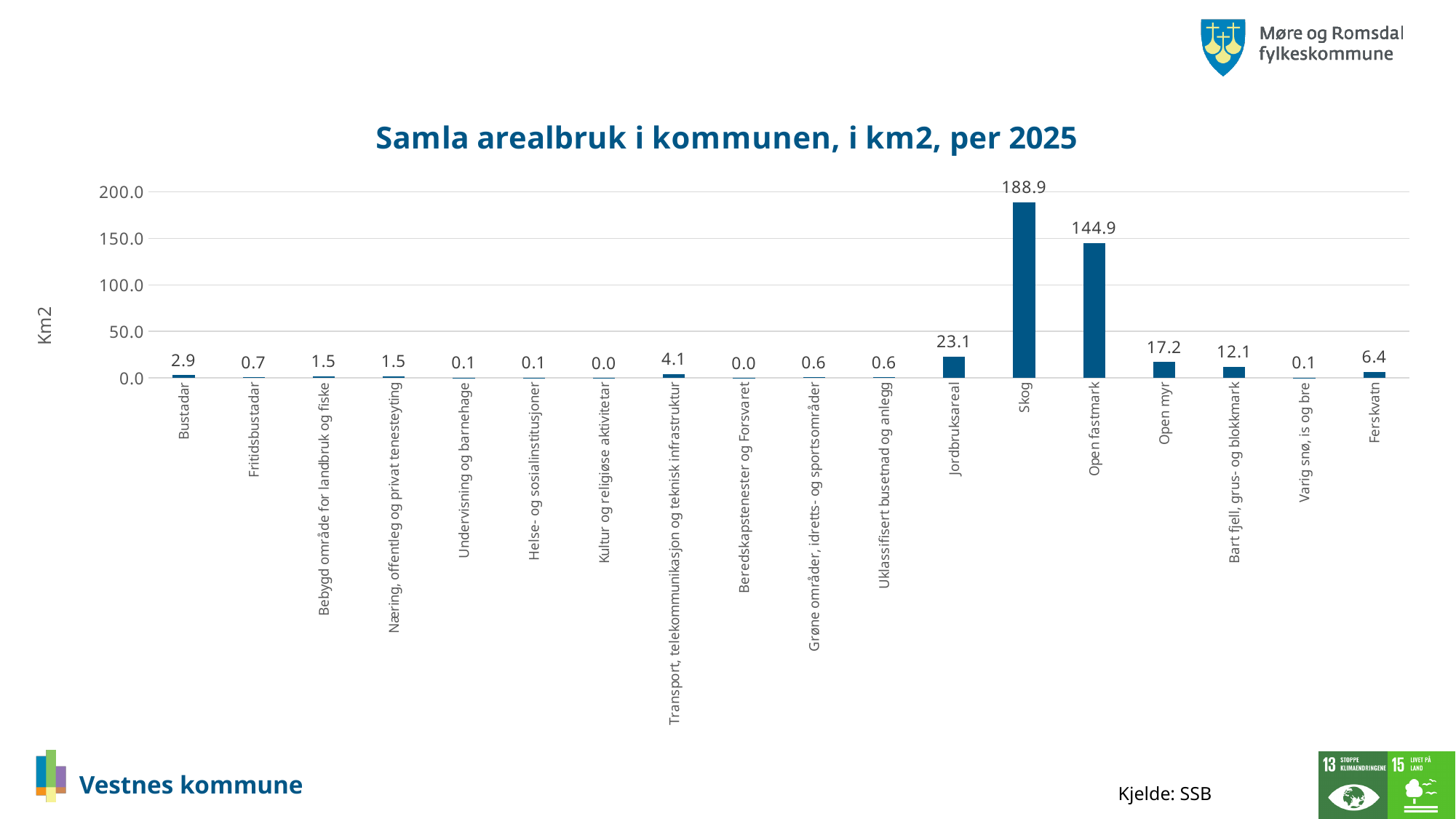
What is the difference between the values for Jordbruksareal and Open myr? 5.9 Is the value for Open fastmark greater or less than 100.0? greater How many categories are shown on the x axis? 18 What is the value for Ferskvatn? 6.4 What is the value for Open fastmark? 144.9 What is the value for Skog? 188.9 What is the title of the chart? Samla arealbruk i kommunen, i km2, per 2025 What is the value for Bart fjell, grus- og blokkmark? 12.1 Which is larger, the value for Open myr or the value for Bart fjell, grus- og blokkmark? Open myr Which category has the highest value? Skog What is the value for Jordbruksareal? 23.1 What is the difference between the values for Skog and Open fastmark? 44.0